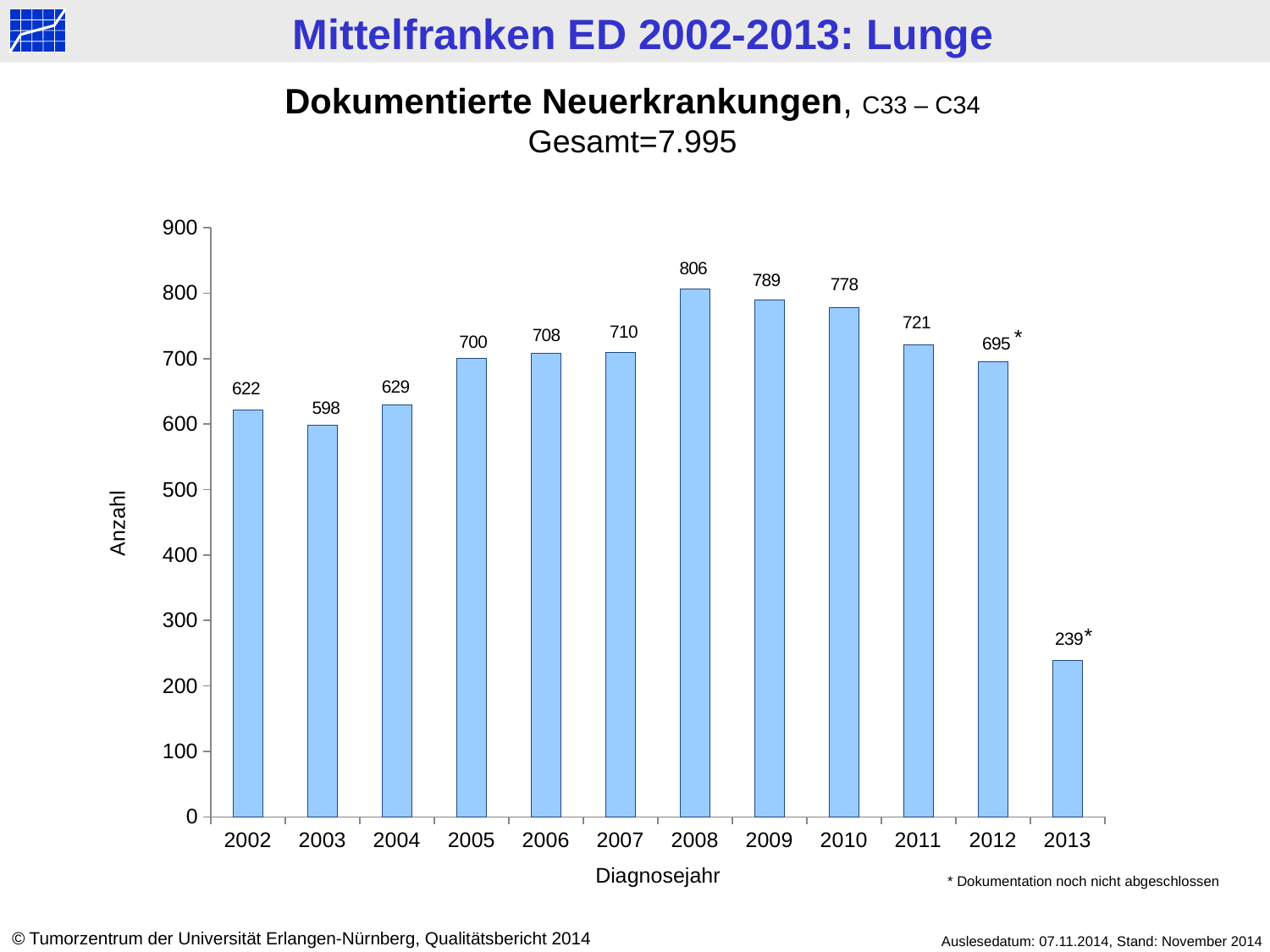
What is the label of the y axis? Anzahl Do the values rise or fall from 2002 to 2008? rise Which year has the highest value? 2008 How many years are shown on the x axis? 12 What is the value for 2003? 598 Which is larger, the value for 2009 or the value for 2010? 2009 What is the value for 2008? 806 What kind of chart is shown? bar chart Is the value for 2011 greater or less than 700? greater What is the value for 2013? 239 Which year has the lowest value? 2013 What is the difference between the values for 2008 and 2002? 184